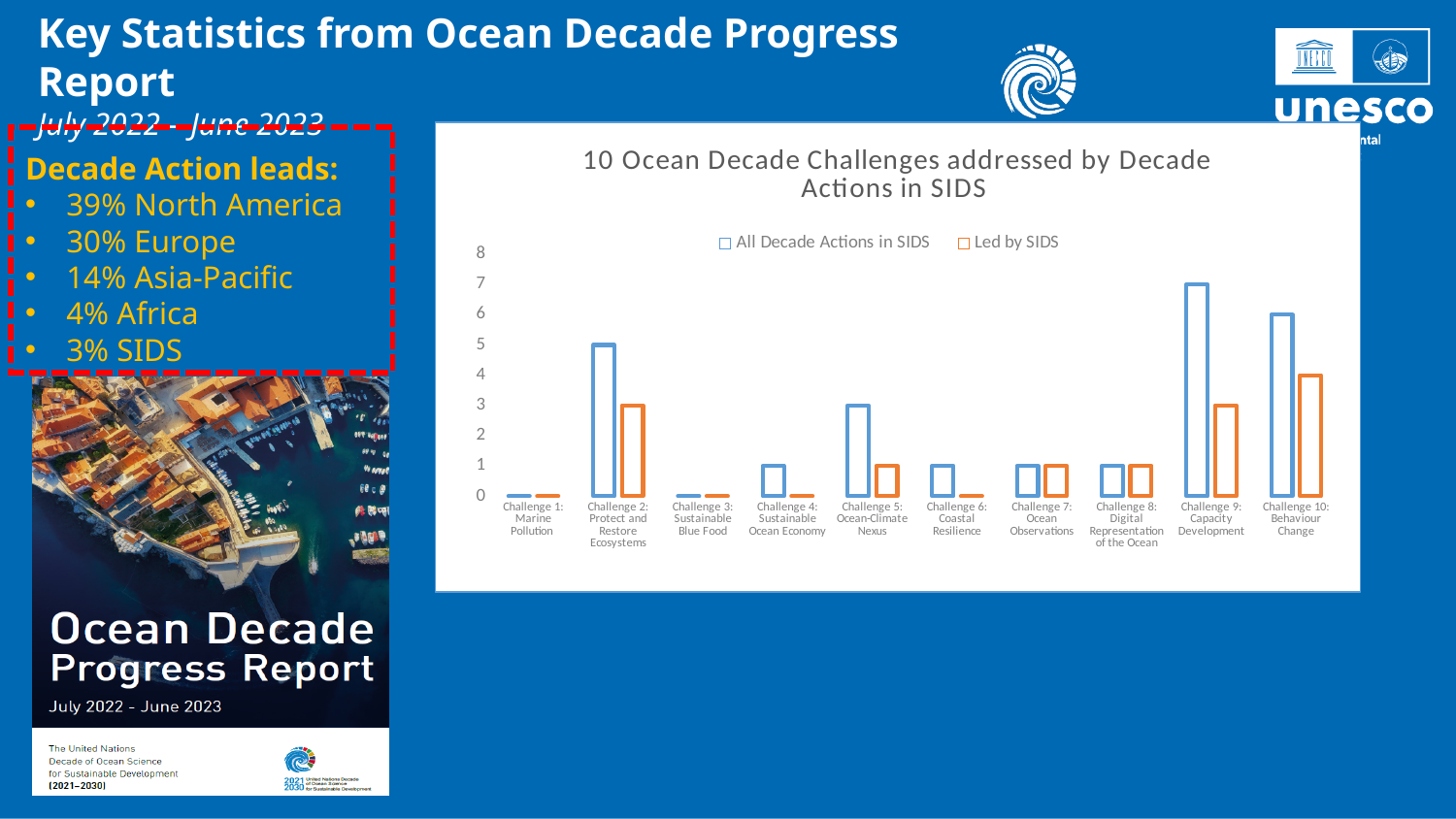
Which challenge has the highest value for Led by SIDS? Challenge 10: Behaviour Change What is the title of the chart? 10 Ocean Decade Challenges addressed by Decade Actions in SIDS Which is larger for Challenge 5: Ocean-Climate Nexus, All Decade Actions in SIDS or Led by SIDS? All Decade Actions in SIDS What is the value for Led by SIDS for Challenge 10: Behaviour Change? 4 Which challenge has the highest value for All Decade Actions in SIDS? Challenge 9: Capacity Development What is the value for All Decade Actions in SIDS for Challenge 9: Capacity Development? 7 How many series does the chart legend list? 2 What type of chart is shown on the slide? bar chart How many challenge categories are shown on the x axis of the chart? 10 What is the difference between All Decade Actions in SIDS and Led by SIDS for Challenge 9: Capacity Development? 4 Is the value for All Decade Actions in SIDS for Challenge 10: Behaviour Change greater or less than 5? greater What is the value for All Decade Actions in SIDS for Challenge 2: Protect and Restore Ecosystems? 5